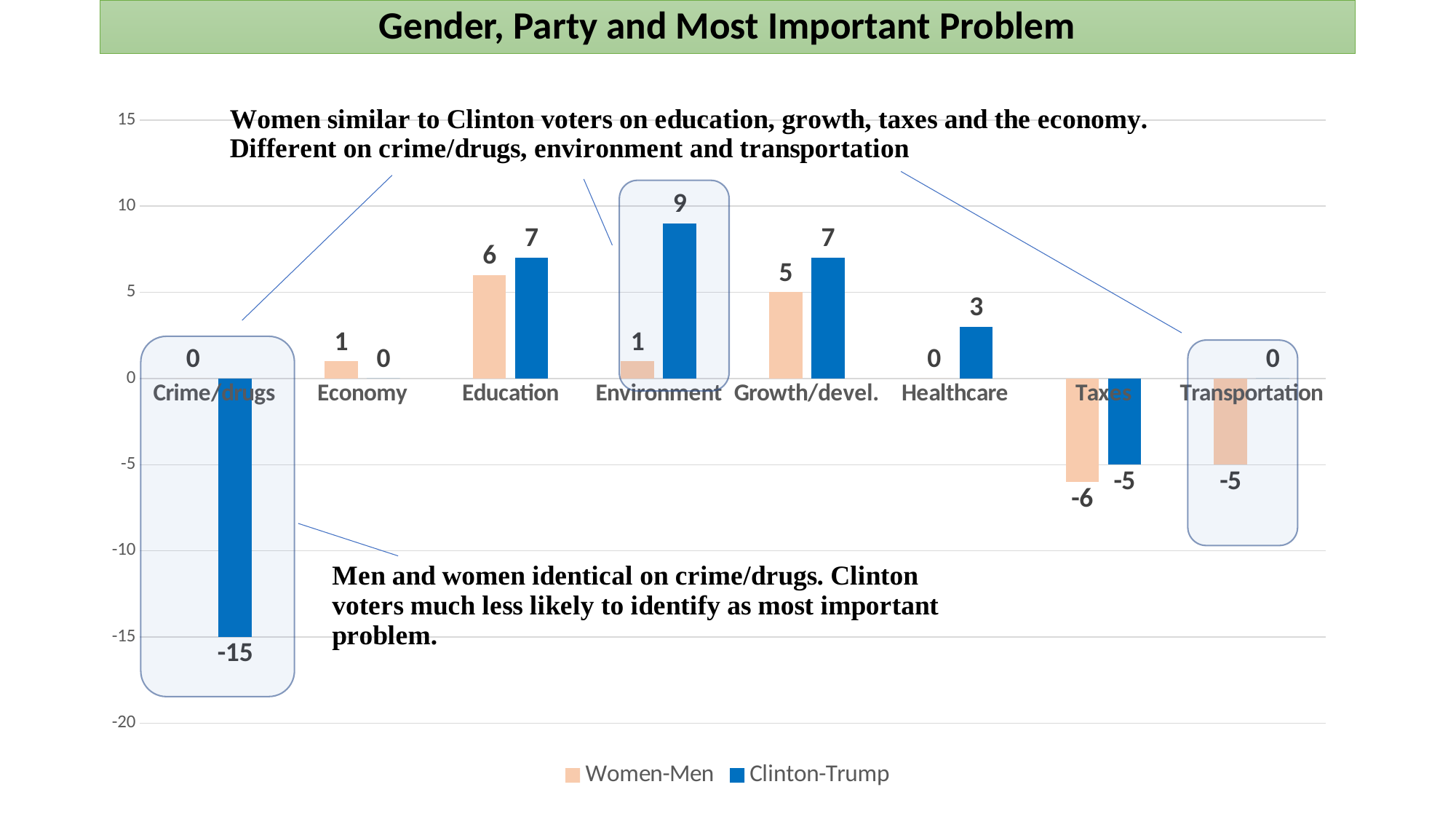
How many series does the legend list? 2 How many categories are shown on the x axis? 8 Which category has the lowest Clinton-Trump value? Crime/drugs What is the title of the slide? Gender, Party and Most Important Problem What is the Clinton-Trump value for Crime/drugs? -15 What kind of chart is shown on the slide? Bar chart What is the Women-Men value for Education? 6 Which category has the highest Clinton-Trump value? Environment What is the Women-Men value for Taxes? -6 Which is larger for Growth/devel., the Women-Men value or the Clinton-Trump value? Clinton-Trump What is the Clinton-Trump value for Environment? 9 What is the difference between the Clinton-Trump and Women-Men values for Environment? 8